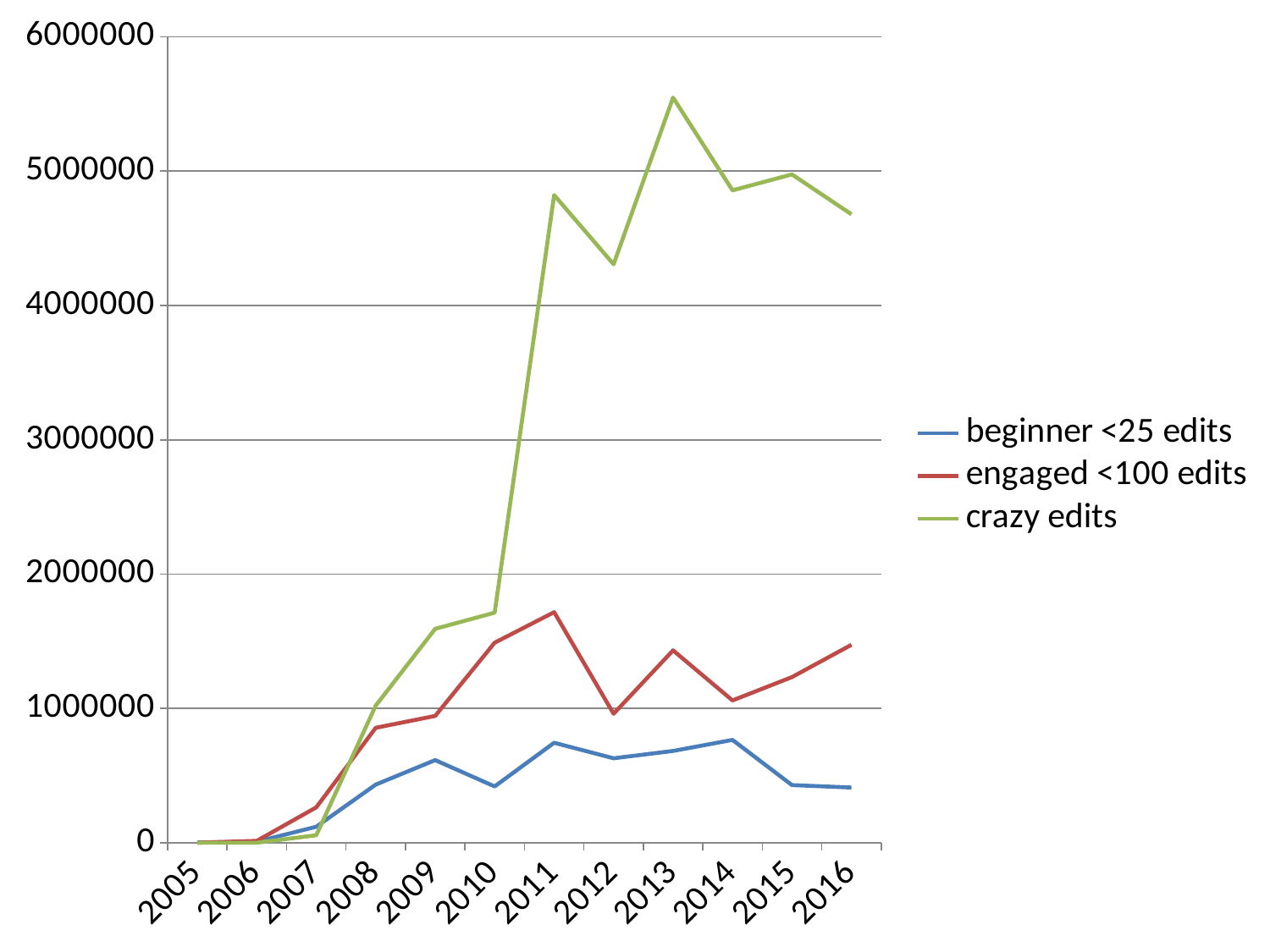
Which is larger in 2016, the value for engaged <100 edits or the value for beginner <25 edits? engaged <100 edits Is the value for beginner <25 edits in 2014 greater or less than 1000000? less What kind of chart is shown on the slide? line chart Which series has the highest value in 2016? crazy edits In which year does the crazy edits series reach its highest value? 2013 Is the value for engaged <100 edits in 2011 greater or less than 1000000? greater Does the crazy edits series rise or fall between 2005 and 2011? rise Is the value for crazy edits in 2012 greater or less than 5000000? less What colour is the line for crazy edits? green How many years are plotted along the x axis? 12 How many series does the legend list? 3